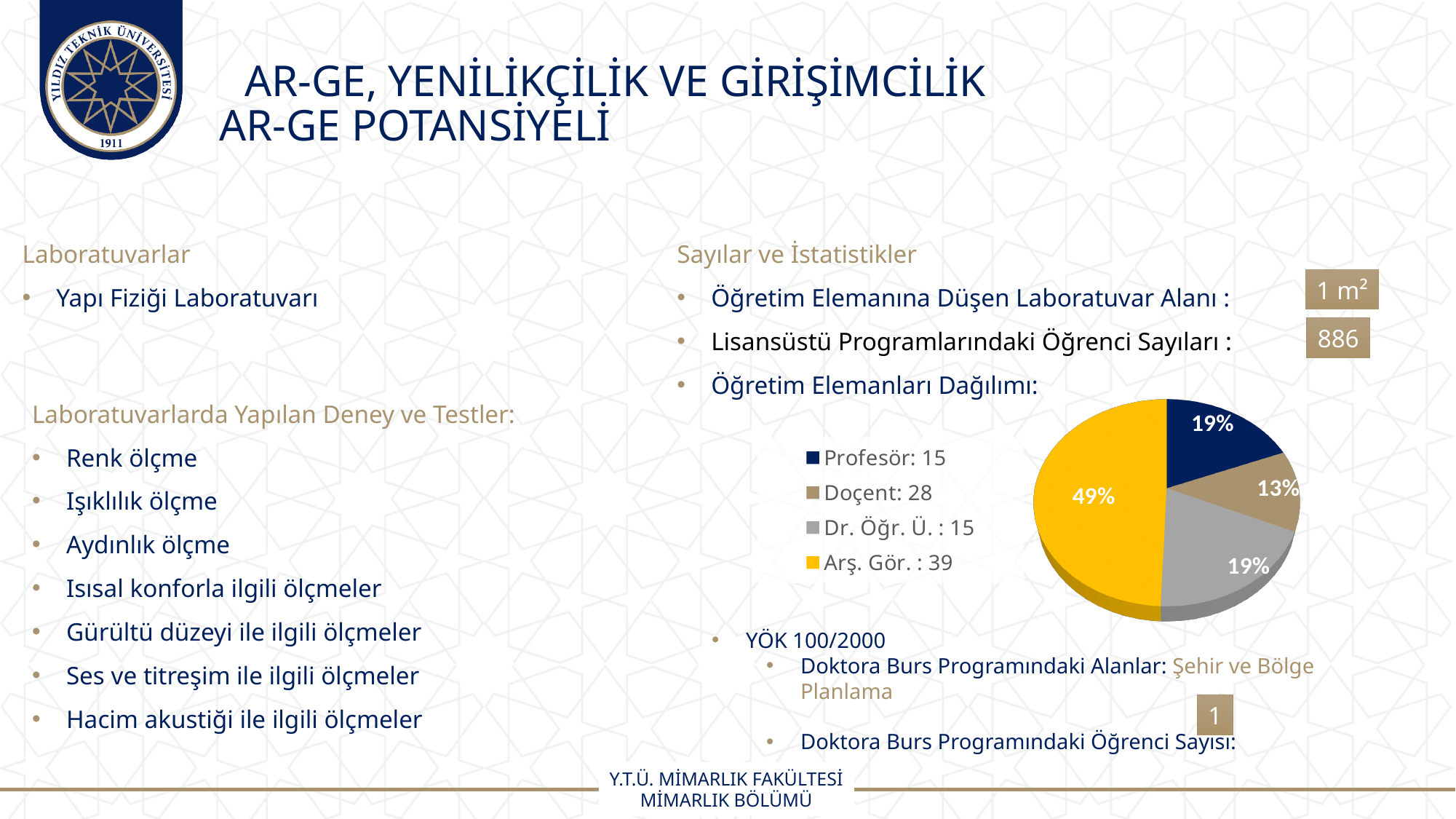
What colour is the Arş. Gör. slice in the pie chart? yellow How many entries does the pie chart's legend list? 4 What percentage label is shown on the Profesör slice of the pie chart? 19% What percentage label is shown on the Arş. Gör. slice of the pie chart? 49% Which category has the largest slice in the pie chart? Arş. Gör. What number is shown next to Doçent in the pie chart's legend? 28 What kind of chart is shown on the slide? pie chart What is the difference in percentage points between the Arş. Gör. slice (49%) and the Doçent slice (13%)? 36% What percentage label is shown on the Doçent slice of the pie chart? 13% How many slices does the pie chart have? 4 Which slice is larger in the pie chart, Arş. Gör. or Doçent? Arş. Gör. Which category has the smallest slice in the pie chart? Doçent